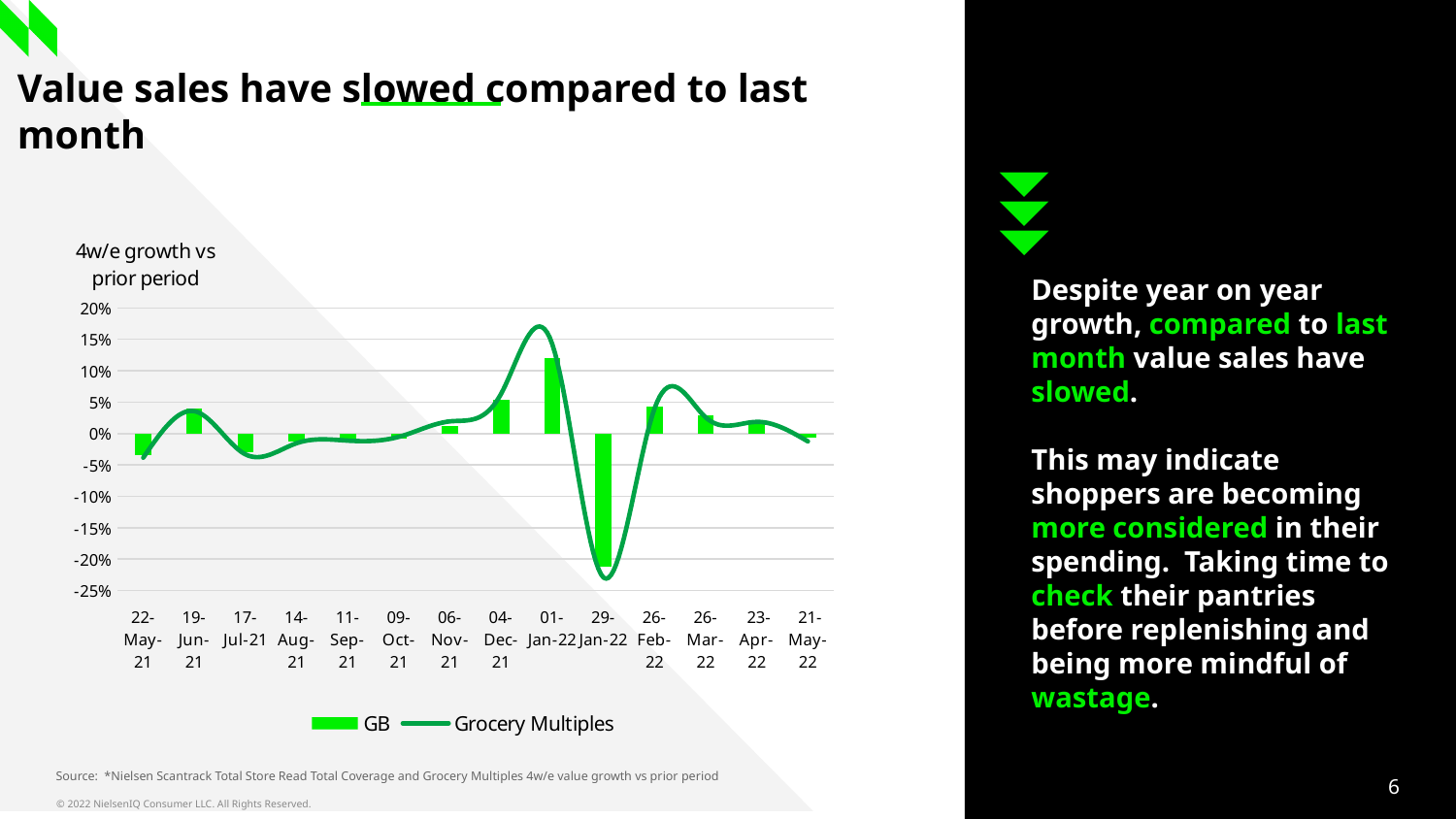
What kind of chart is shown on the slide? A combination bar and line chart Which has the larger GB value, 04-Dec-21 or 01-Jan-22? 01-Jan-22 How many periods are shown along the x axis of the chart? 14 Which series is shown as bars in the chart? GB Is the GB value for 01-Jan-22 greater or less than 5%? greater In which period is the GB bar highest? 01-Jan-22 How many series does the chart legend list? 2 In which period is the GB bar lowest? 29-Jan-22 Which series is shown as a line in the chart? Grocery Multiples Is the GB value for 29-Jan-22 greater or less than -15%? less Is the Grocery Multiples value for 29-Jan-22 greater or less than -20%? less